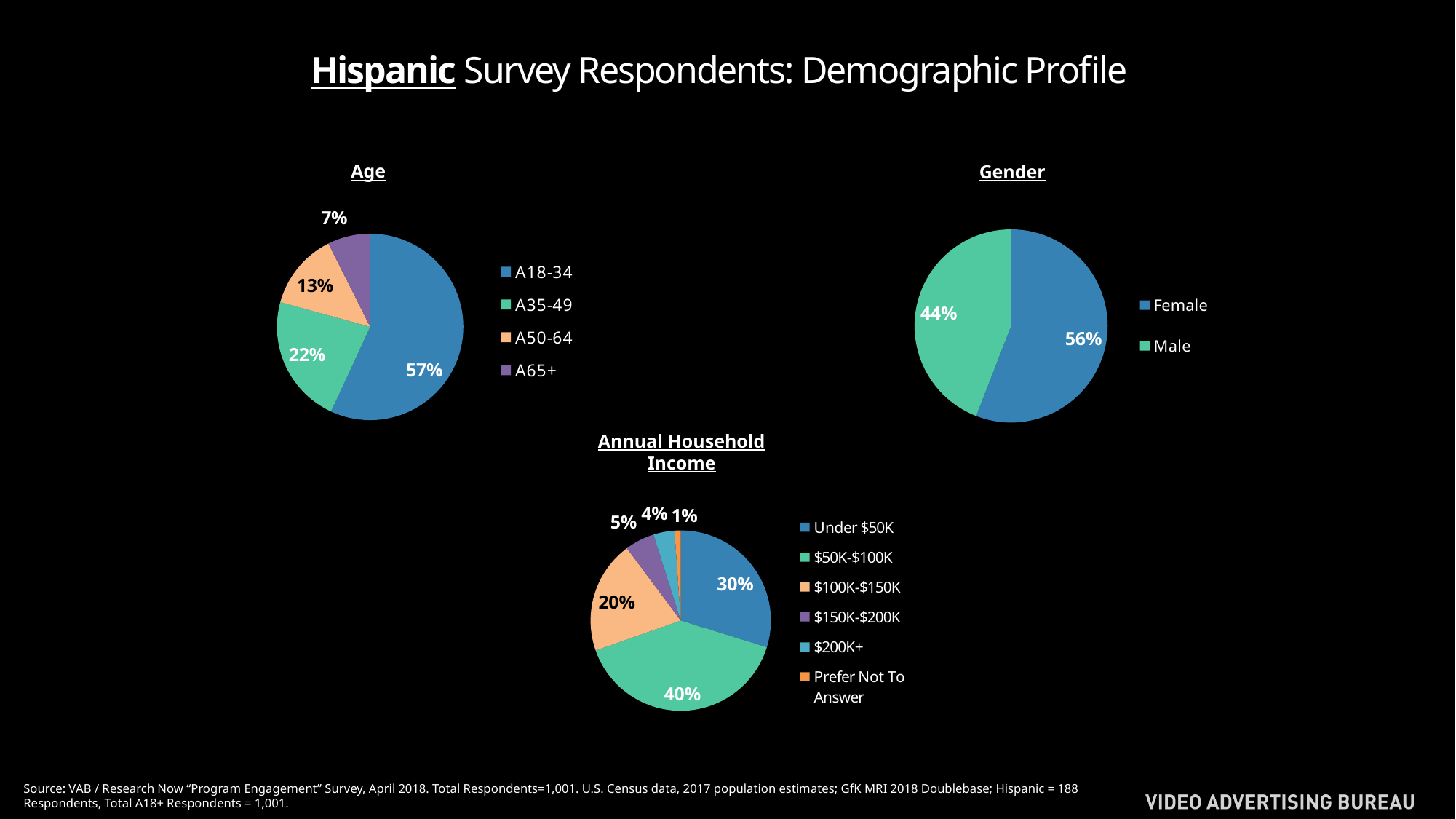
What type of chart is used for the Gender breakdown? Pie chart In the Gender chart, which is larger, the Female share or the Male share? Female In the Annual Household Income chart, how many categories does the legend list? 6 In the Annual Household Income chart, which category has the largest share? $50K-$100K In the Gender chart, what share of respondents are Male? 44% In the Age chart, what share of respondents are A18-34? 57% In the Annual Household Income chart, what share of respondents chose Prefer Not To Answer? 1% In the Age chart, how many age categories are shown? 4 In the Age chart, what is the difference between the A35-49 share and the A50-64 share? 9% In the Annual Household Income chart, what share of respondents earn $50K-$100K? 40% In the Age chart, which age group has the smallest share? A65+ In the Gender chart, what is the difference between the Female and Male shares? 12%